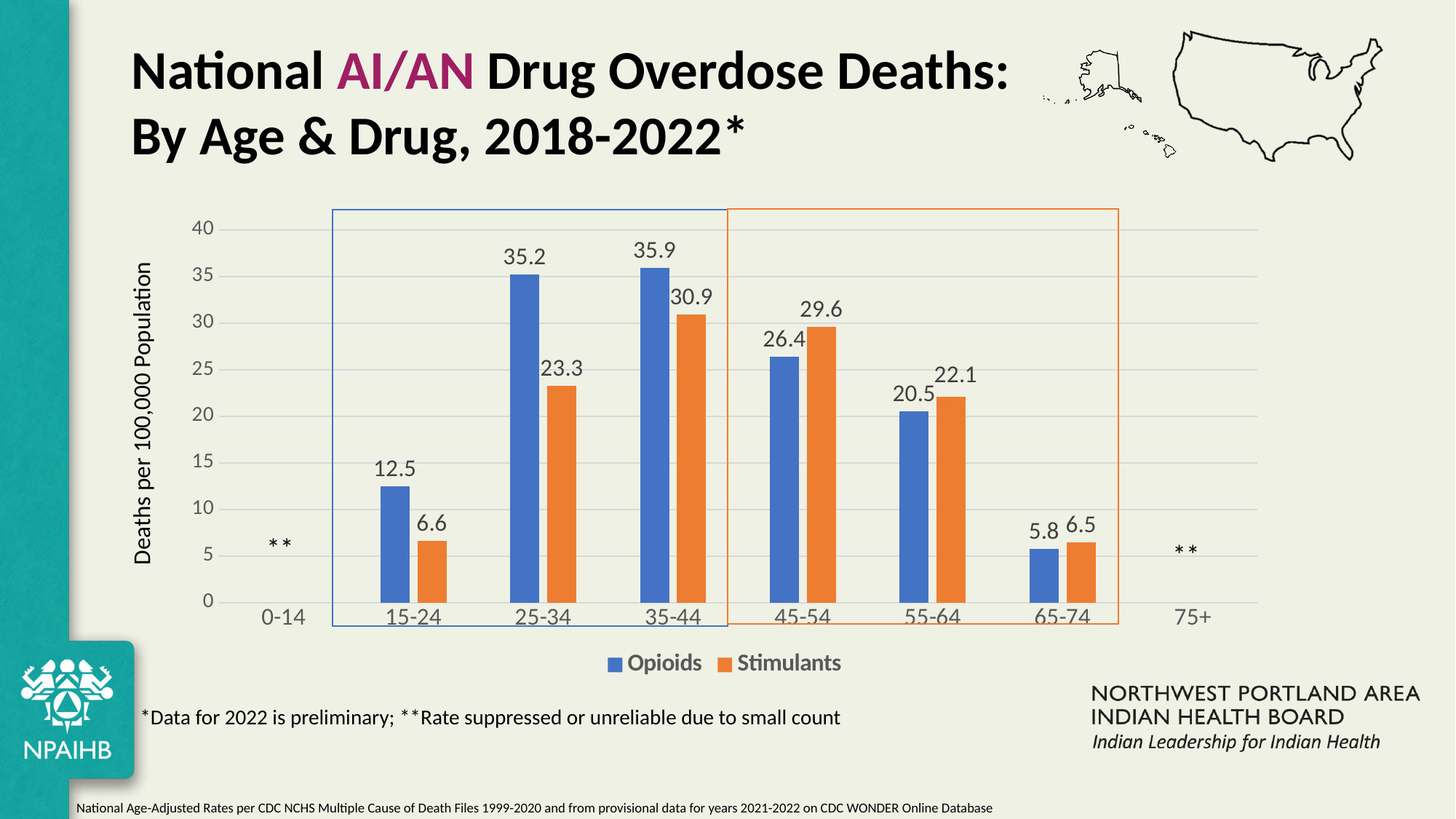
Which age group has the lowest Stimulants value among those with a plotted bar? 65-74 What is the Stimulants value for the 45-54 age group? 29.6 What is the Opioids value for the 25-34 age group? 35.2 Which age groups have rates marked as suppressed or unreliable (**)? 0-14 and 75+ For the 15-24 age group, which is larger: Opioids or Stimulants? Opioids What is the difference between the Opioids and Stimulants values for the 35-44 age group? 5.0 Which age group has the highest Opioids value? 35-44 What is the Opioids value for the 65-74 age group? 5.8 How many series does the legend list? 2 For the 45-54 age group, which is larger: Opioids or Stimulants? Stimulants What kind of chart is shown on the slide? Bar chart How many age group categories are shown on the x axis? 8